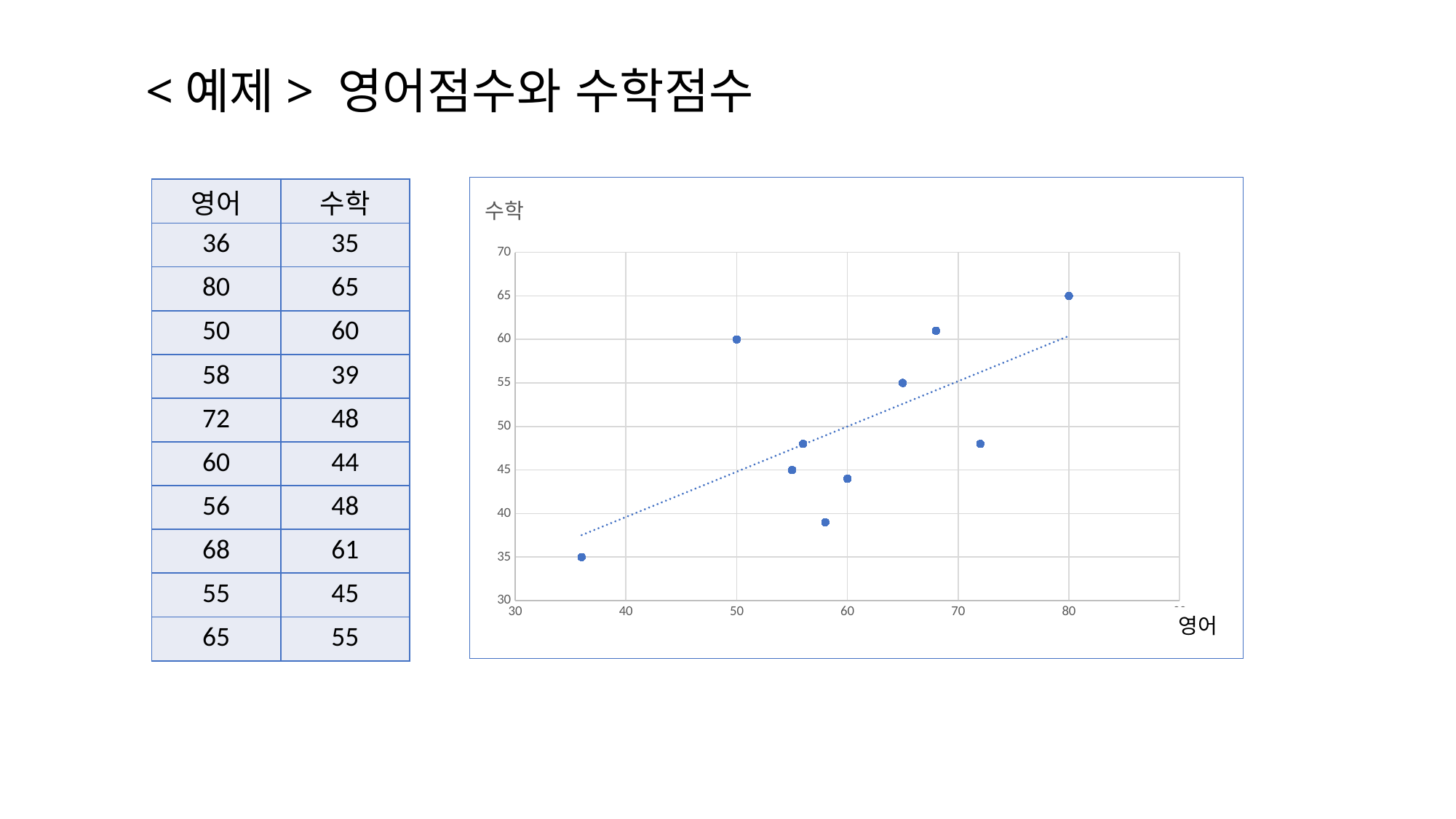
Does the dotted trend line rise or fall as the 영어 score increases? rises What is the title of the horizontal axis of the chart? 영어 What is the title of the vertical axis of the chart? 수학 What is the difference between the highest and lowest 수학 scores plotted? 30 Which has the higher 수학 score: the point with 영어 score 58 or the point with 영어 score 60? 영어 score 60 Is the 수학 score for the point with an 영어 score of 72 greater or less than 50? less How many data points are plotted in the chart? 10 What kind of chart is shown on the slide? scatter chart What is the 수학 score for the point with an 영어 score of 50? 60 What is the highest 수학 score plotted in the chart? 65 What is the lowest 수학 score plotted in the chart? 35 What is the 수학 score for the point with an 영어 score of 68? 61